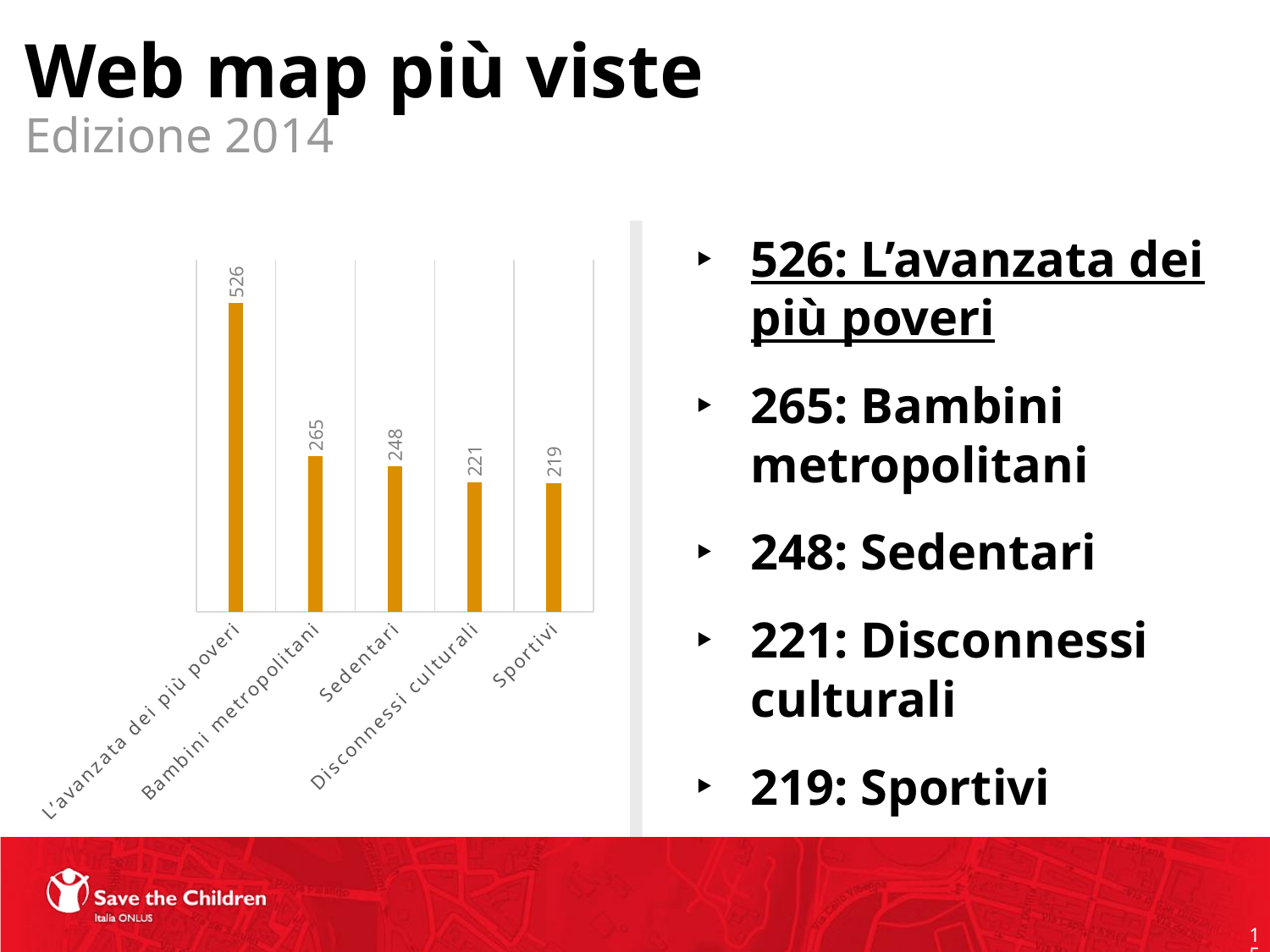
What is the value for Disconnessi culturali? 221 Which category has the highest value? L'avanzata dei più poveri What is the value for Bambini metropolitani? 265 Which is larger, the value for Bambini metropolitani or the value for Sedentari? Bambini metropolitani Do the values rise or fall from left to right along the x axis? Fall Which category has the lowest value? Sportivi What is the value for Sportivi? 219 How many categories are shown in the chart? 5 What is the value for Sedentari? 248 What is the difference between the values for Sedentari and Sportivi? 29 What is the difference between the values for L'avanzata dei più poveri and Bambini metropolitani? 261 What kind of chart is shown on the slide? Bar chart